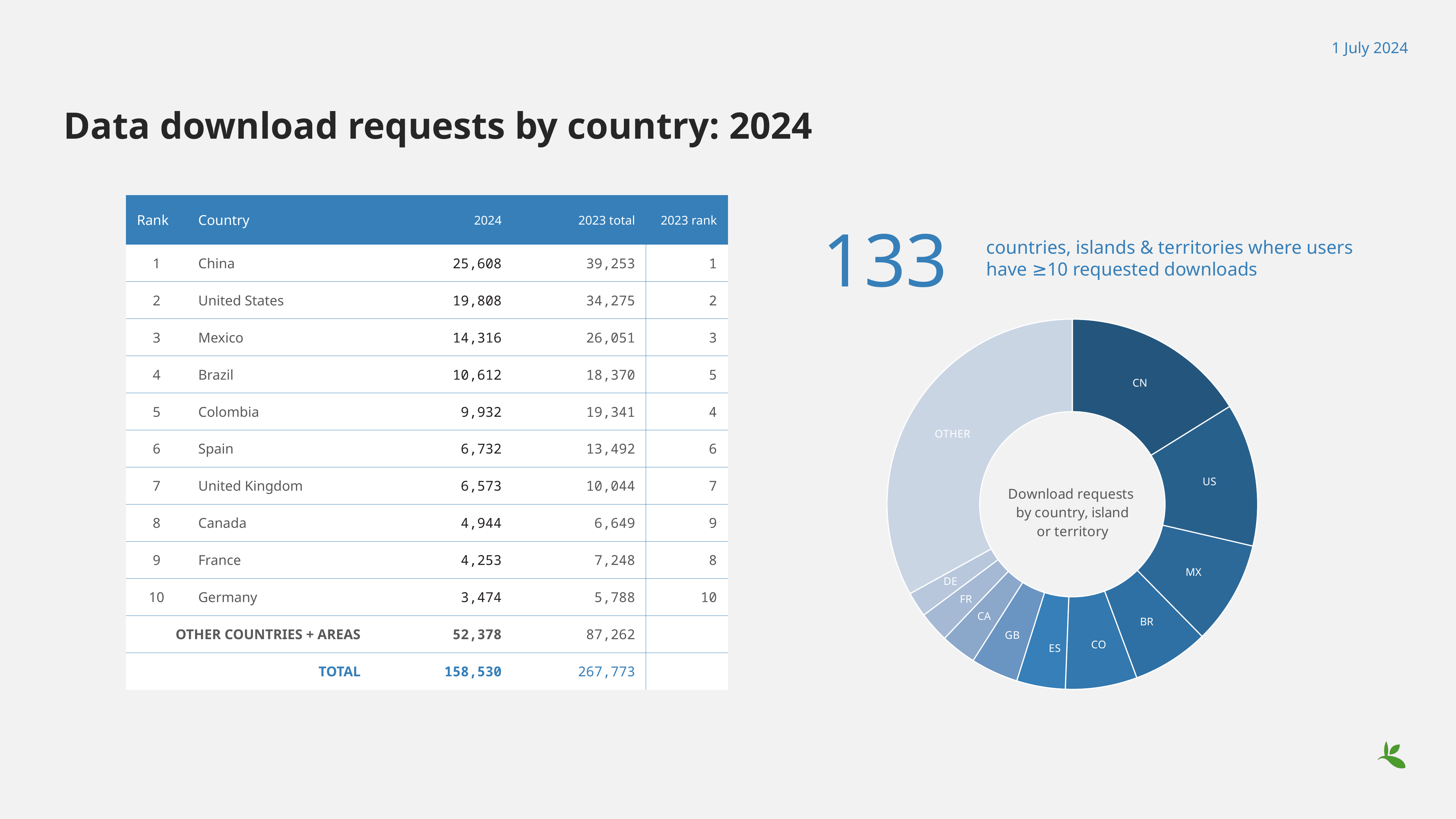
How many slices does the donut chart have? 11 What is the difference in 2024 download requests between the US and Mexico slices, using the table values? 5,492 According to the table, how many download requests did China (CN) have in 2024? 25,608 What text is written in the centre of the donut chart? Download requests by country, island or territory What kind of chart is shown on the right of the slide? Donut (pie) chart Which slice is larger in the donut chart, US or MX? US Which country slice (excluding OTHER) is the largest in the donut chart? CN According to the table, how many download requests did the OTHER COUNTRIES + AREAS slice represent in 2024? 52,378 What is the total number of download requests in 2024 shown in the table? 158,530 Which slice is larger in the donut chart, BR or GB? BR Which slice of the donut chart is the largest? OTHER Which labelled slice of the donut chart is the smallest? DE